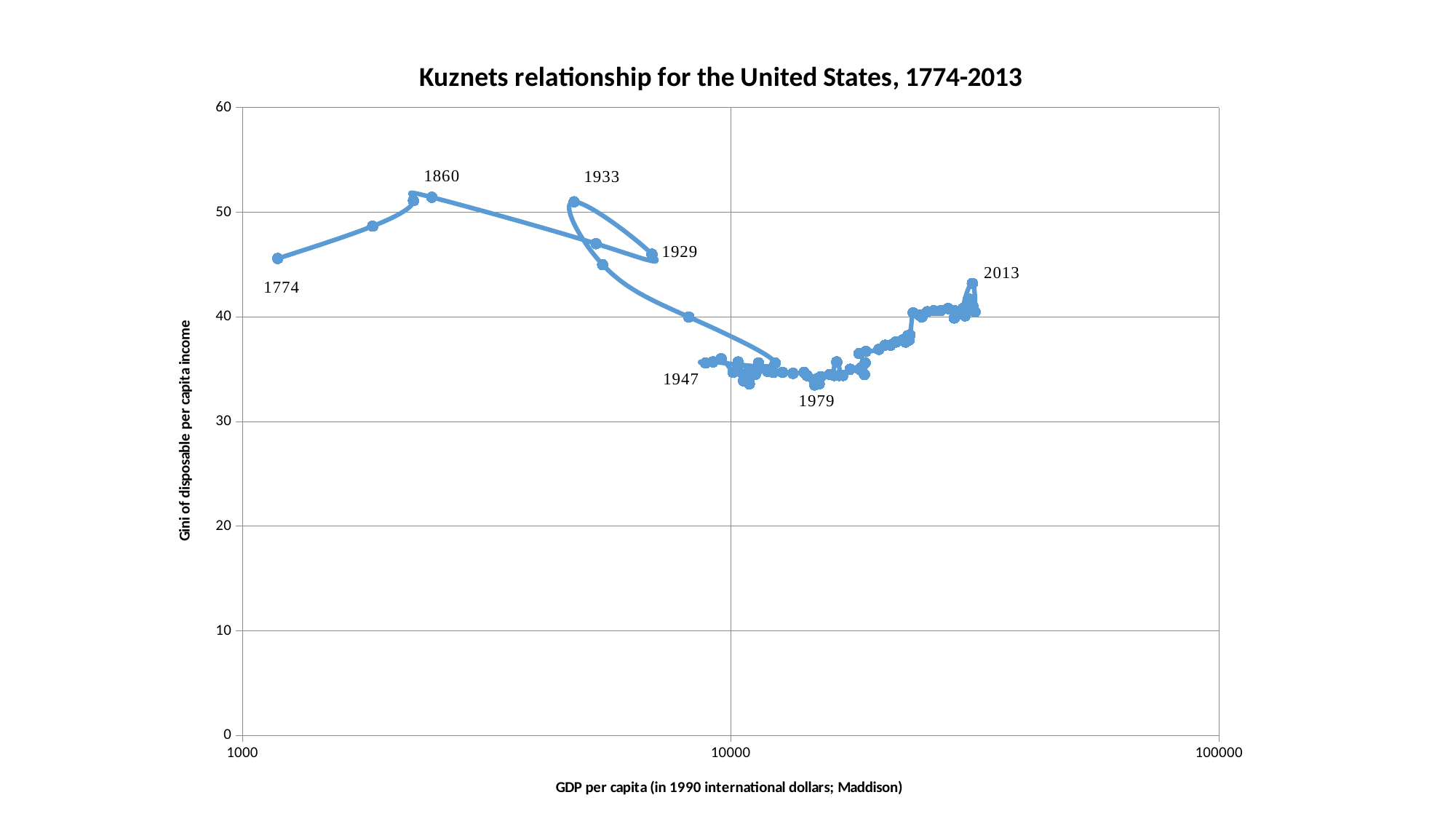
Is the Gini value for the point labelled 2013 greater or less than 40? greater Which of the labelled points has a higher Gini value, 1774 or 1947? 1774 Which of the labelled points has a higher Gini value, 1860 or 1979? 1860 What kind of chart is shown on the slide? scatter chart with connected points Is the Gini value for the point labelled 1774 greater or less than 40? greater How many points on the chart are labelled with a year? 7 Among the labelled years, which has the lowest Gini value? 1979 Is the Gini value for the point labelled 1929 greater or less than 50? less What is the label of the vertical axis? Gini of disposable per capita income What is the title of the chart? Kuznets relationship for the United States, 1774-2013